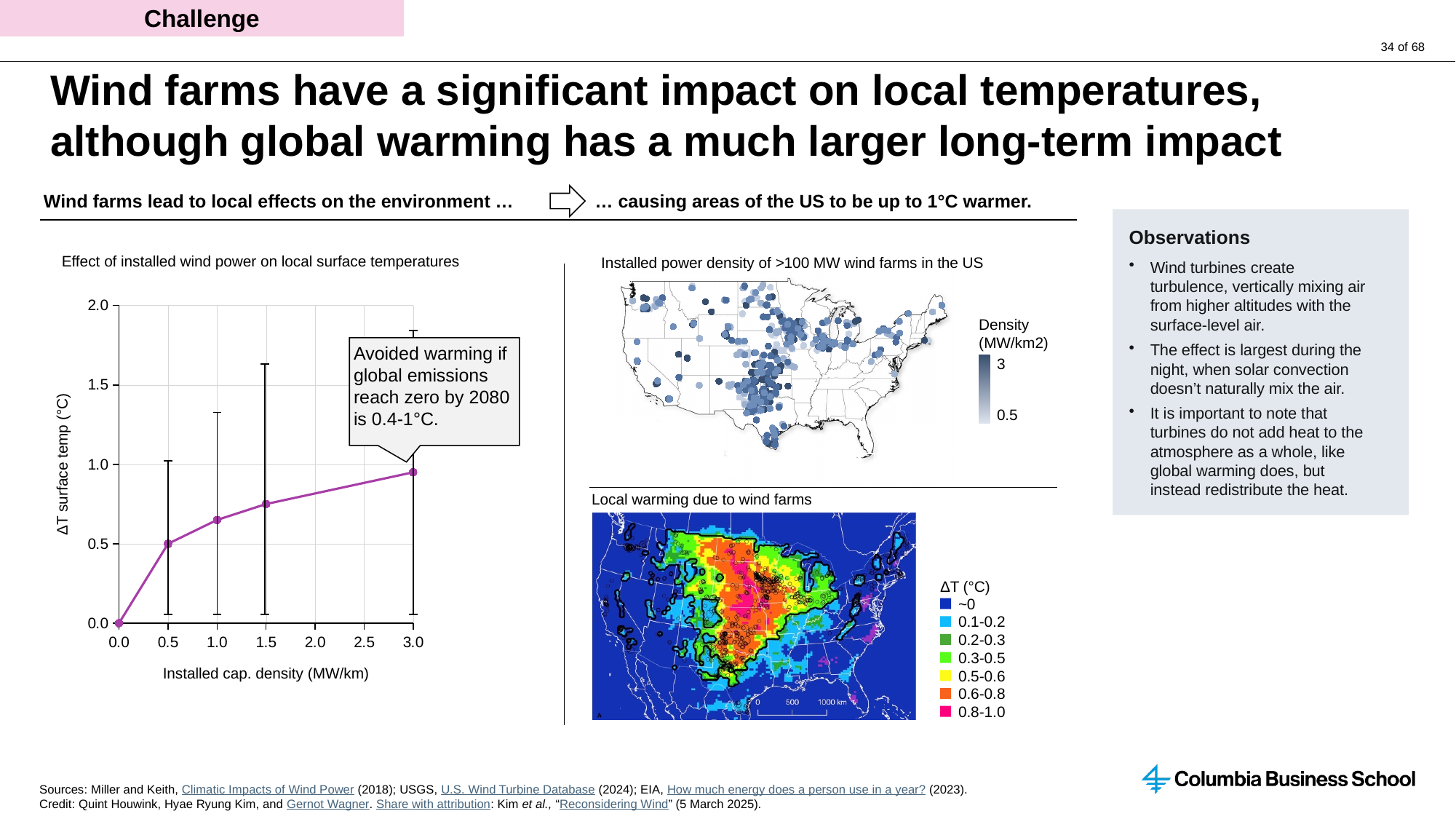
What kind of chart is 'Effect of installed wind power on local surface temperatures'? line chart In the chart 'Effect of installed wind power on local surface temperatures', what is the ΔT surface temp at an installed capacity density of 0.0? 0.0 In the chart 'Effect of installed wind power on local surface temperatures', what is the ΔT surface temp at an installed capacity density of 0.5? 0.5 In the chart 'Effect of installed wind power on local surface temperatures', at which installed capacity density is the ΔT surface temp highest? 3.0 In the chart 'Effect of installed wind power on local surface temperatures', is the ΔT value at an installed capacity density of 1.0 greater or less than 0.5? greater In the chart 'Effect of installed wind power on local surface temperatures', is the ΔT value at an installed capacity density of 3.0 greater or less than 0.5? greater In the chart 'Effect of installed wind power on local surface temperatures', does the ΔT surface temp rise or fall as installed capacity density increases? rise In the chart 'Effect of installed wind power on local surface temperatures', is the ΔT value at an installed capacity density of 1.5 greater or less than 1.0? less What is the x-axis label of the chart 'Effect of installed wind power on local surface temperatures'? Installed cap. density (MW/km) In the chart 'Effect of installed wind power on local surface temperatures', at which installed capacity density is the ΔT surface temp lowest? 0.0 In the chart 'Effect of installed wind power on local surface temperatures', which has the larger ΔT surface temp: an installed capacity density of 0.5 or 3.0? 3.0